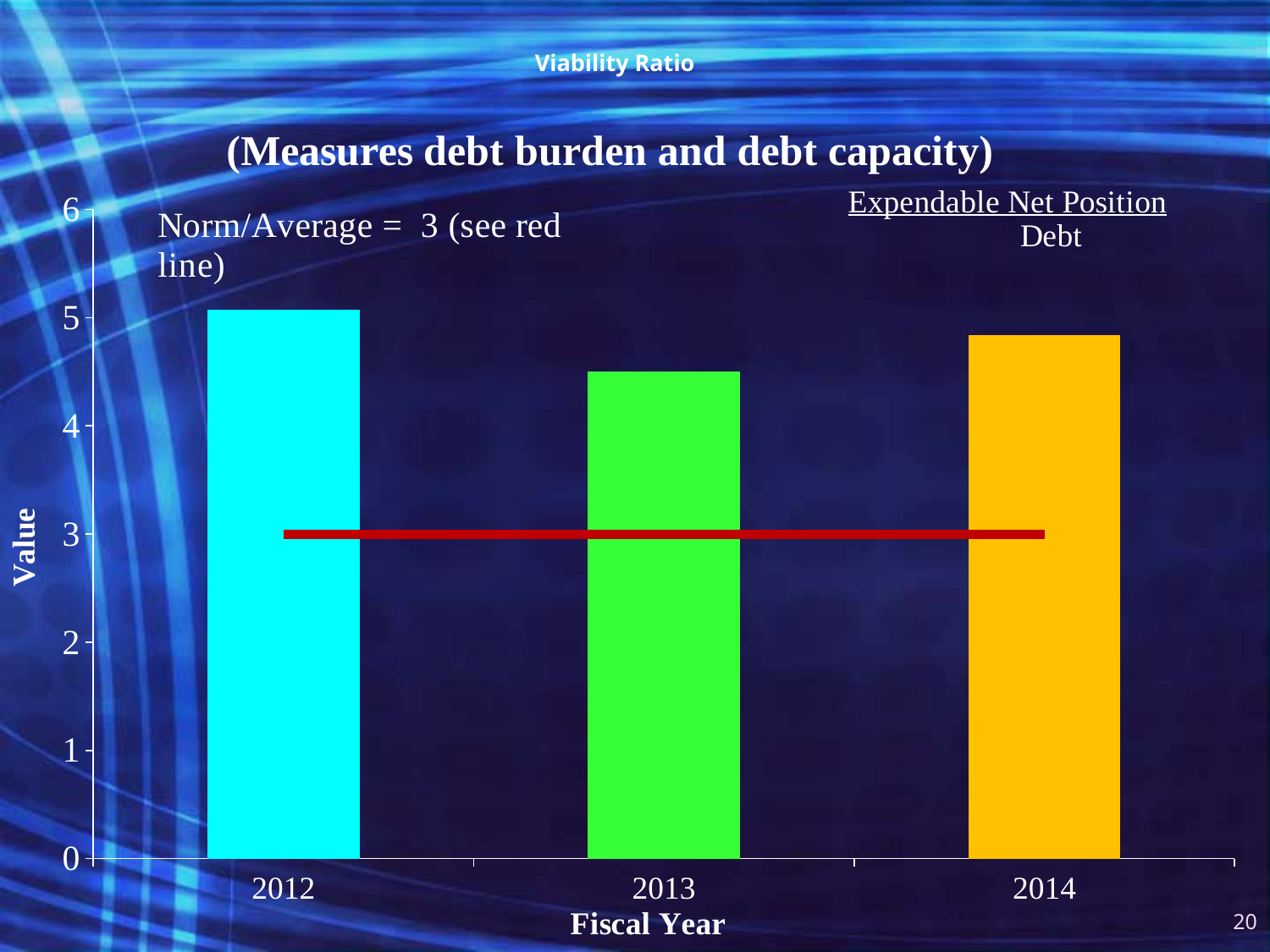
Which fiscal year has the lowest viability ratio? 2013 Which is larger, the value for 2012 or the value for 2013? 2012 What value does the red line on the chart represent? 3 Is the value for 2014 greater or less than 4? greater Is the value for 2013 greater or less than 5? less What kind of chart is shown on the slide? bar chart Is the value for 2013 greater or less than 3? greater Do the values rise or fall from 2012 to 2013? fall Which fiscal year has the highest viability ratio? 2012 What is the title of the x axis? Fiscal Year How many fiscal years are plotted on the chart? 3